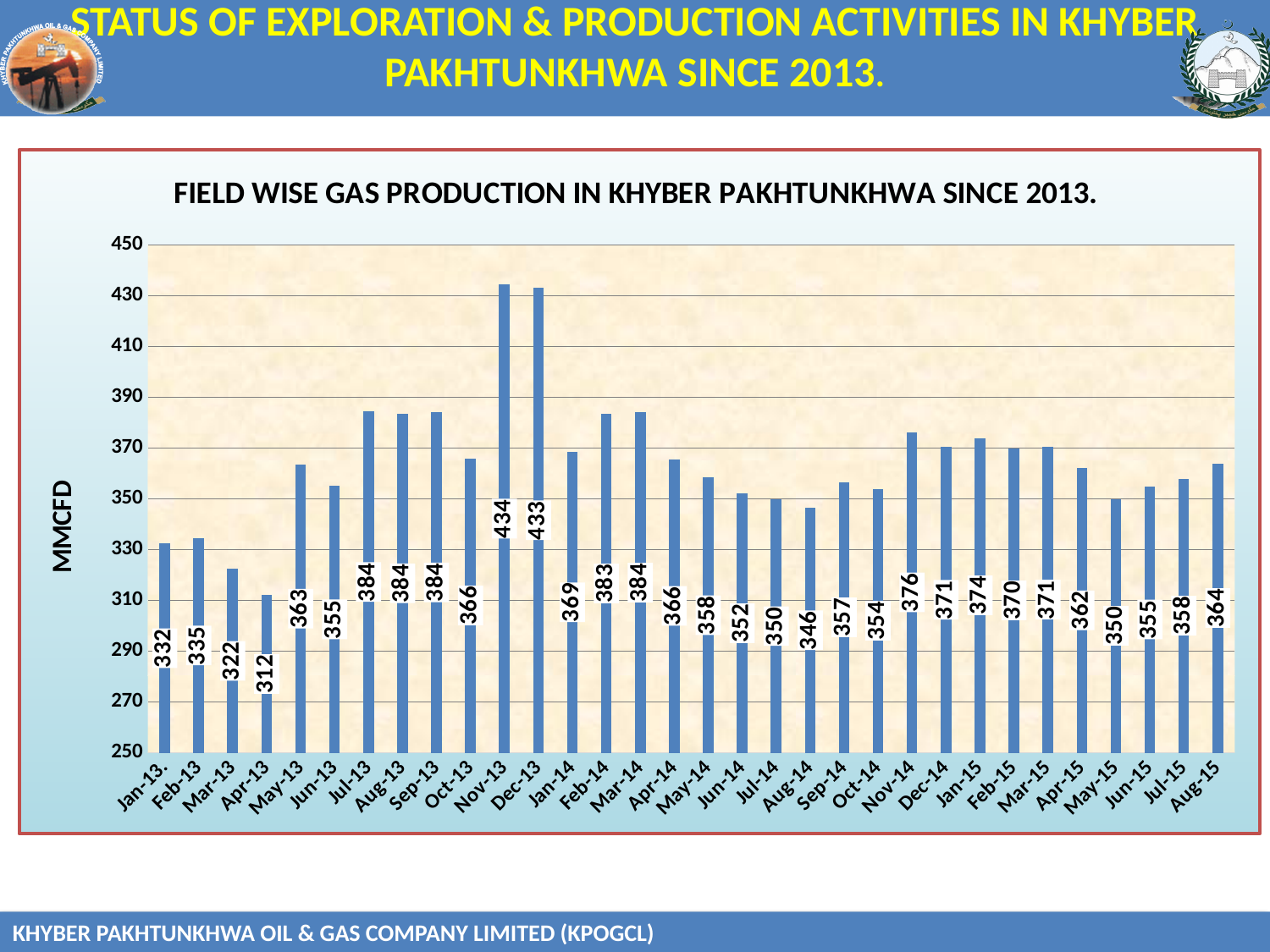
Which is larger, the gas production in Nov-14 or in Aug-14? Nov-14 What is the gas production value for Nov-13? 434 What type of chart is shown on the slide? Bar chart Is the gas production value for Dec-13 greater or less than 410? greater Which month has the lowest gas production? Apr-13 How many months are plotted on the chart? 32 Which month has the highest gas production? Nov-13 What is the gas production value for Aug-15? 364 What unit is shown on the y-axis of the chart? MMCFD What is the gas production value for Apr-13? 312 What is the difference between the gas production in Jul-13 and Jan-13? 52 What is the difference between the gas production in Nov-13 and Dec-13? 1